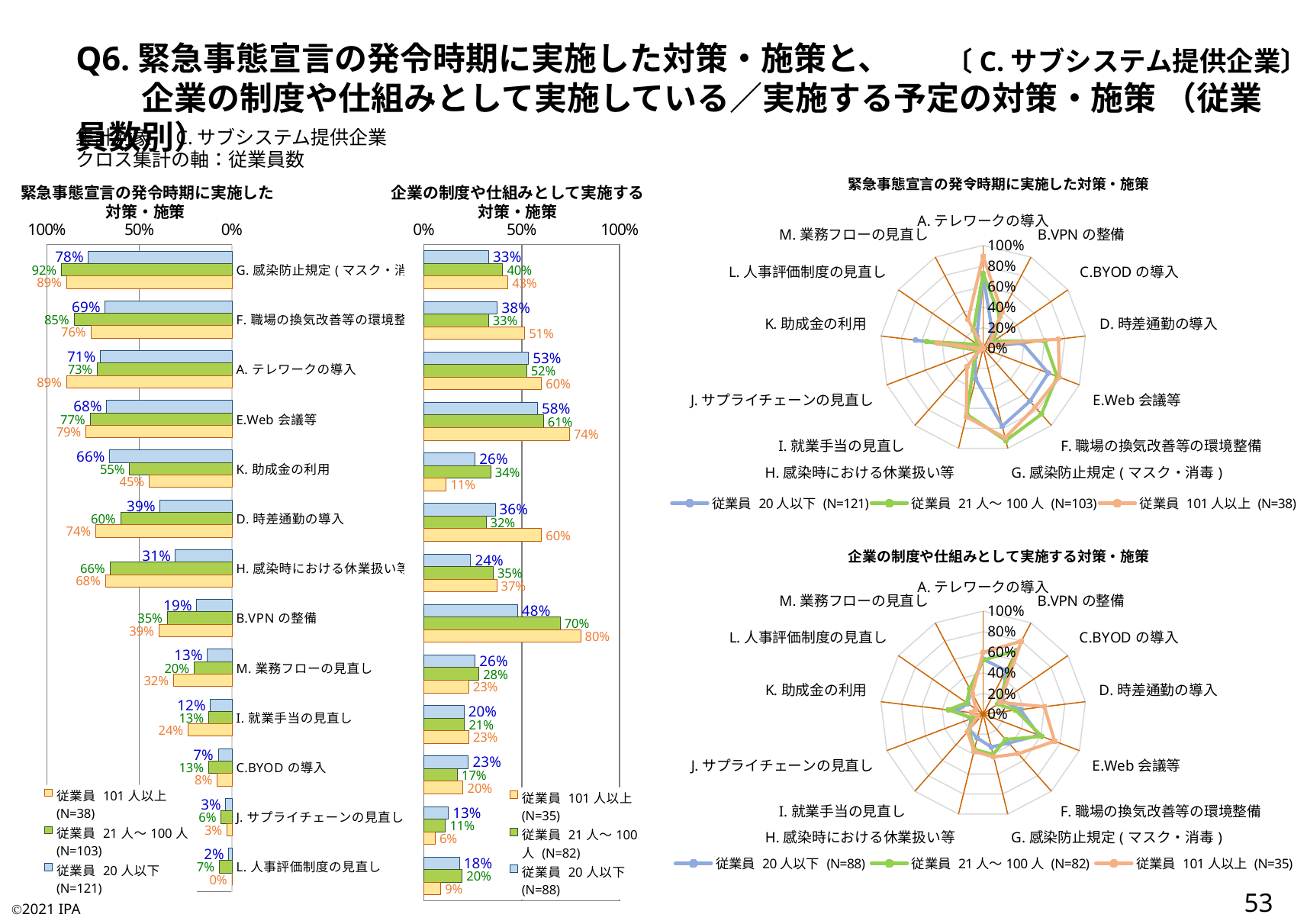
What kind of chart is the chart at the top right titled 緊急事態宣言の発令時期に実施した対策・施策? Radar chart In the left bar chart titled 緊急事態宣言の発令時期に実施した対策・施策, what is the value for K. 助成金の利用 for the 従業員 20人以下 series? 66% In the middle bar chart titled 企業の制度や仕組みとして実施する対策・施策, which is larger for K. 助成金の利用: the 従業員 21人～100人 value or the 従業員 101人以上 value? 従業員 21人～100人 In the left bar chart titled 緊急事態宣言の発令時期に実施した対策・施策, which category has the lowest value for the 従業員 101人以上 series? L. 人事評価制度の見直し How many series does the legend of the left bar chart titled 緊急事態宣言の発令時期に実施した対策・施策 list? 3 In the middle bar chart titled 企業の制度や仕組みとして実施する対策・施策, what is the value for B.VPNの整備 for the 従業員 101人以上 series? 80% In the left bar chart titled 緊急事態宣言の発令時期に実施した対策・施策, what is the difference between the 従業員 101人以上 and 従業員 20人以下 values for D. 時差通勤の導入? 35% In the left bar chart titled 緊急事態宣言の発令時期に実施した対策・施策, what is the value for G. 感染防止規定 for the 従業員 21人～100人 series? 92% In the middle bar chart titled 企業の制度や仕組みとして実施する対策・施策, which category has the lowest value for the 従業員 101人以上 series? J. サプライチェーンの見直し How many categories are plotted in the middle bar chart titled 企業の制度や仕組みとして実施する対策・施策? 13 In the left bar chart titled 緊急事態宣言の発令時期に実施した対策・施策, which category has the highest value for the 従業員 101人以上 series? G. 感染防止規定 and A. テレワークの導入 (tied at 89%) In the middle bar chart titled 企業の制度や仕組みとして実施する対策・施策, what is the value for E.Web会議等 for the 従業員 21人～100人 series? 61%